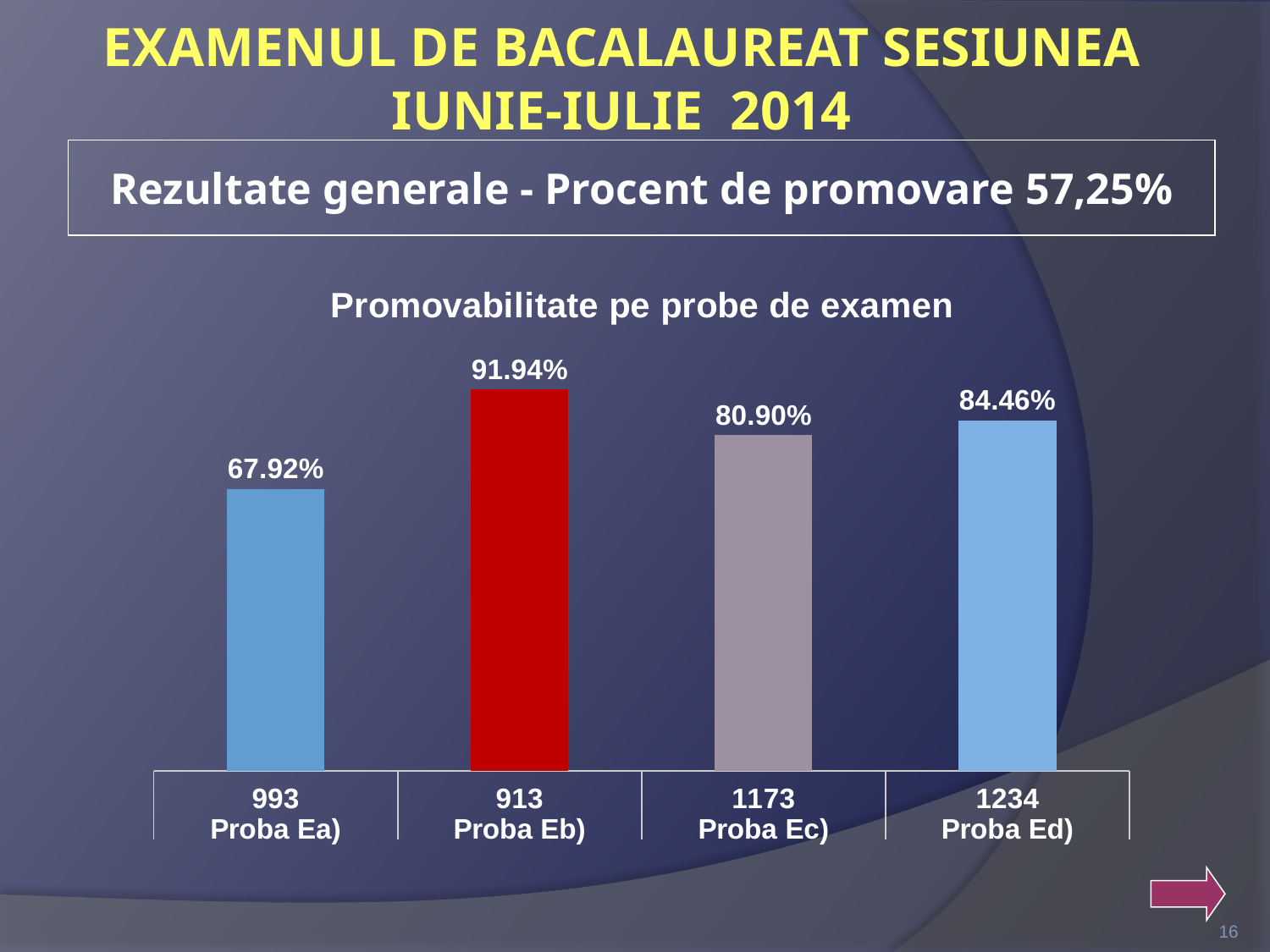
What type of chart is used to show the pass rates per exam test? Bar chart What is the pass rate shown for Proba Ed)? 84.46% What is the title of the chart? Promovabilitate pe probe de examen What number is shown under the label for Proba Ec) on the x axis? 1173 What is the difference in pass rate between Proba Eb) and Proba Ea)? 24.02% What is the pass rate shown for Proba Eb)? 91.94% How many exam tests (probe) are shown in the chart? 4 What is the pass rate shown for Proba Ea)? 67.92% Which has a higher pass rate, Proba Ec) or Proba Ed)? Proba Ed) What is the pass rate shown for Proba Ec)? 80.90% Which exam test (proba) has the lowest pass rate? Proba Ea) Which exam test (proba) has the highest pass rate? Proba Eb)